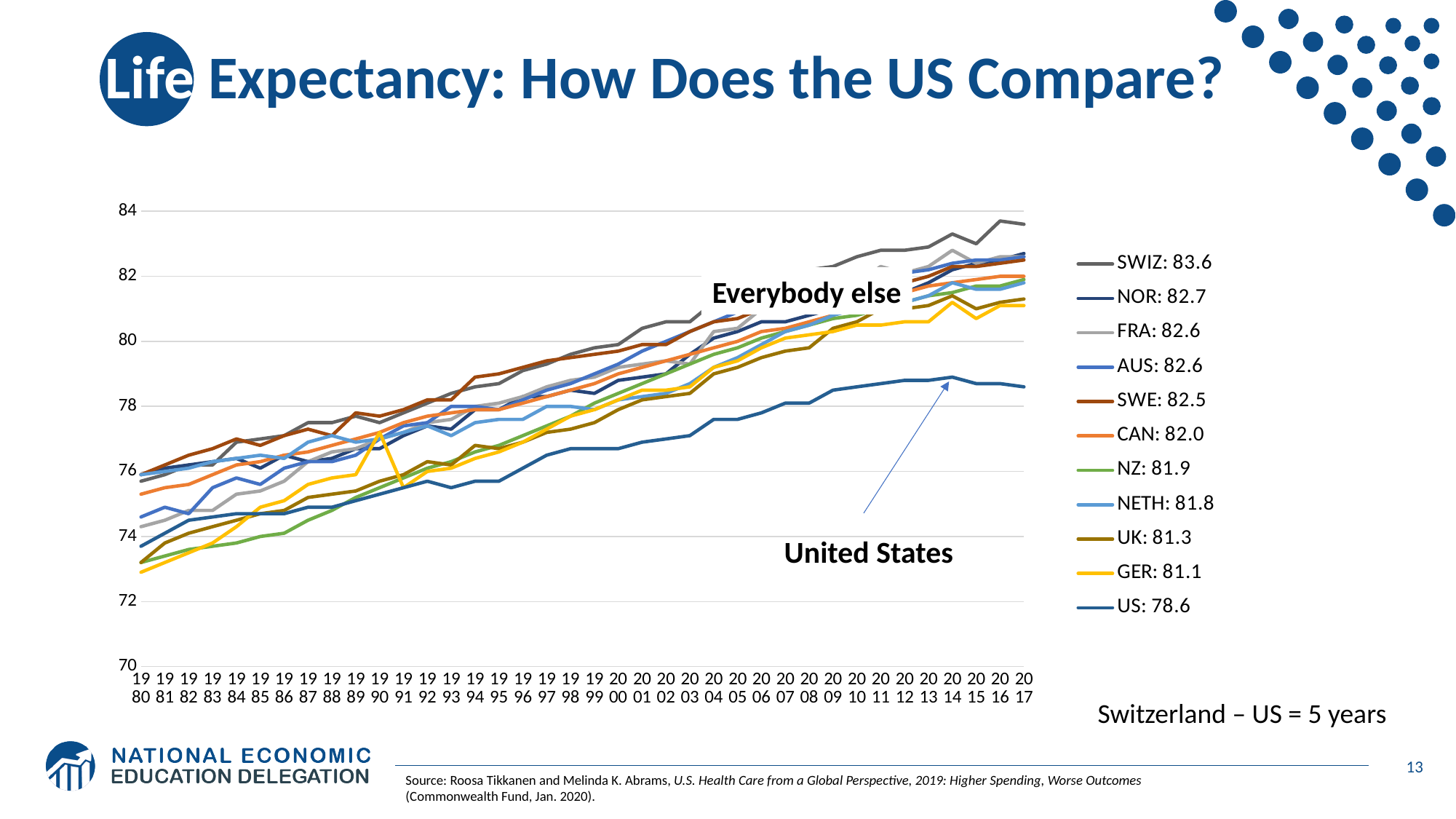
Is the value for the US line in 2017 greater or less than 80? less What value does the legend show for SWIZ? 83.6 Which country has the lowest value in the legend? US What value does the legend show for GER? 81.1 Does the US line generally rise or fall from 1980 to 2017? rise Which country has the highest value in the legend? SWIZ Which has a higher legend value, NOR or UK? NOR What value does the legend show for US? 78.6 How many series does the legend list? 11 What is the difference between the legend values for SWIZ and US? 5.0 What value does the legend show for CAN? 82.0 What kind of chart is shown on the slide? line chart